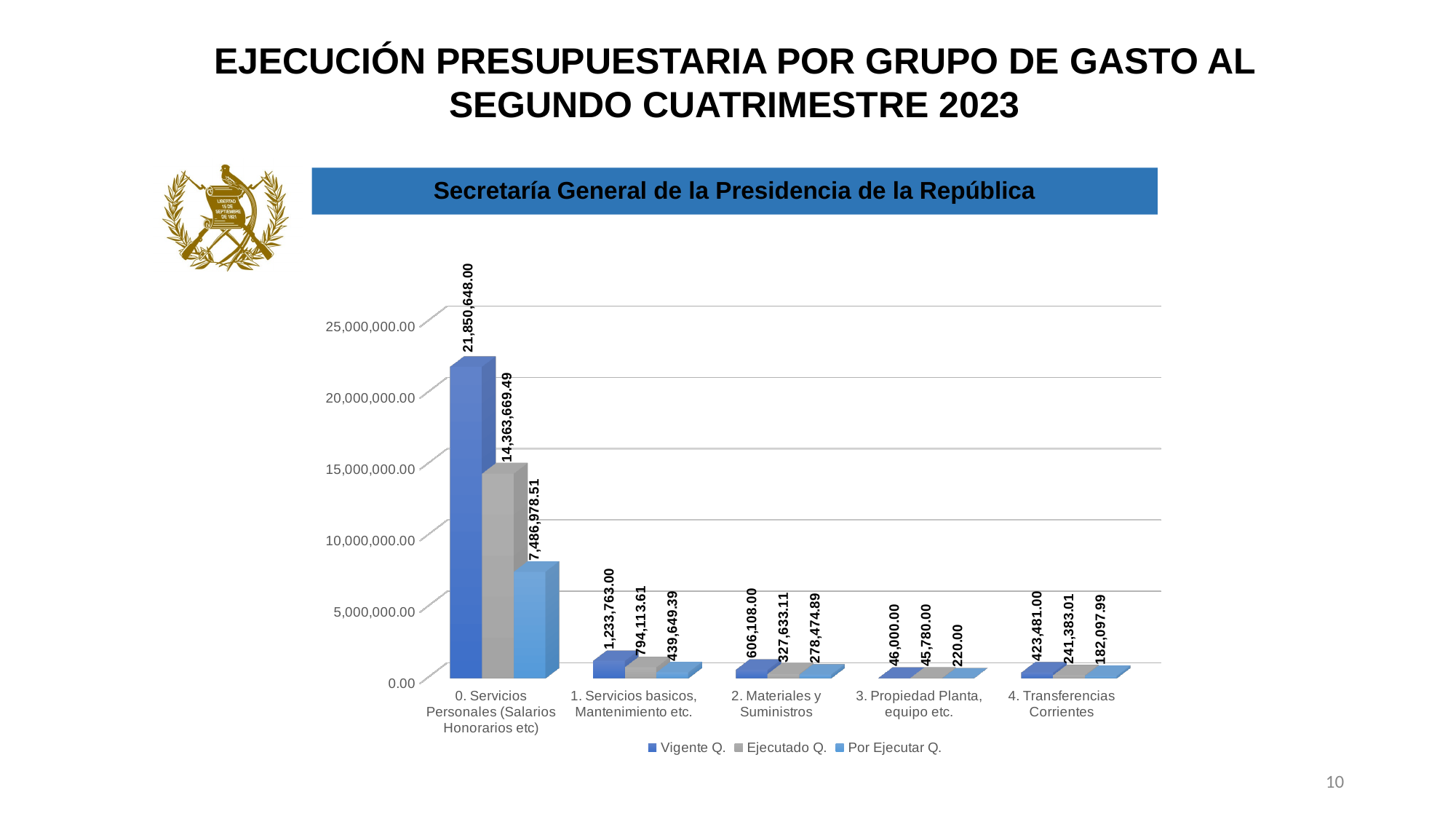
What kind of chart is shown on the slide? bar chart How many series does the legend list? 3 What is the Ejecutado Q. value for 4. Transferencias Corrientes? 241,383.01 Is the Ejecutado Q. value for 0. Servicios Personales (Salarios Honorarios etc) greater or less than 15,000,000.00? less What is the Por Ejecutar Q. value for 3. Propiedad Planta, equipo etc.? 220.00 Which category has the highest Vigente Q. value? 0. Servicios Personales (Salarios Honorarios etc) What is the difference between the Vigente Q. and Ejecutado Q. values for 0. Servicios Personales (Salarios Honorarios etc)? 7,486,978.51 Which is larger: the Vigente Q. value for 2. Materiales y Suministros or the Vigente Q. value for 4. Transferencias Corrientes? 2. Materiales y Suministros How many expense group categories are shown on the x axis? 5 What is the Vigente Q. value for 0. Servicios Personales (Salarios Honorarios etc)? 21,850,648.00 Which category has the lowest Por Ejecutar Q. value? 3. Propiedad Planta, equipo etc. What is the Ejecutado Q. value for 1. Servicios basicos, Mantenimiento etc.? 794,113.61